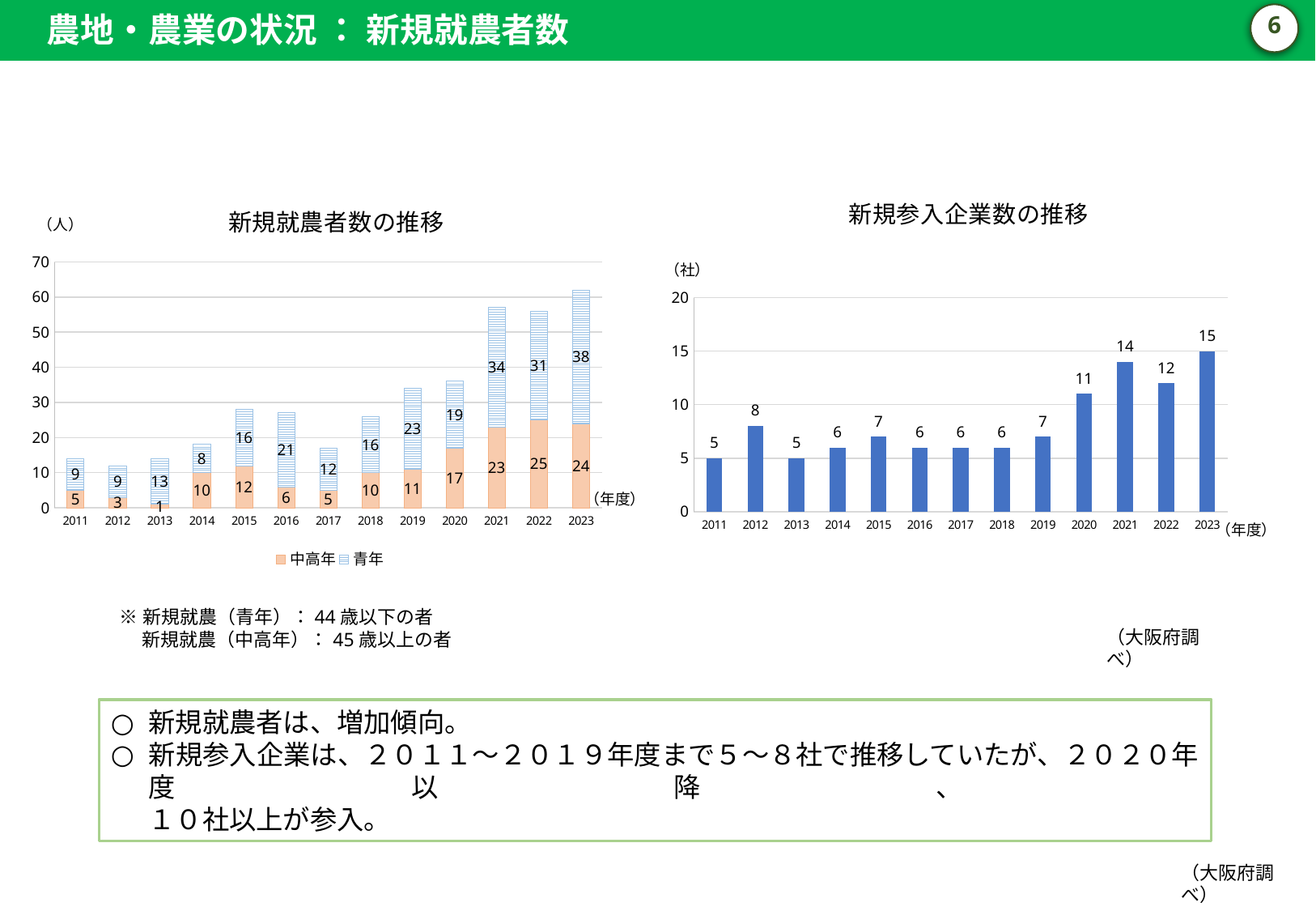
What kind of chart is the 新規参入企業数の推移 chart? bar chart In the 新規参入企業数の推移 chart, which is larger, the value for 2012 or the value for 2019? 2012 In the 新規就農者数の推移 chart, which year has the lowest value for 中高年? 2013 In the 新規参入企業数の推移 chart, which year has the highest value? 2023 In the 新規就農者数の推移 chart, what is the total of the stacked bar for 2021? 57 In the 新規就農者数の推移 chart, what is the value for 中高年 in 2020? 17 In the 新規参入企業数の推移 chart, what is the value for 2021? 14 In the 新規就農者数の推移 chart, what is the value for 青年 in 2023? 38 In the 新規参入企業数の推移 chart, how many years are shown on the x axis? 13 In the 新規参入企業数の推移 chart, what is the difference between the values for 2023 and 2011? 10 In the 新規就農者数の推移 chart, how many series does the legend list? 2 In the 新規就農者数の推移 chart, what is the difference between the 青年 values for 2023 and 2022? 7